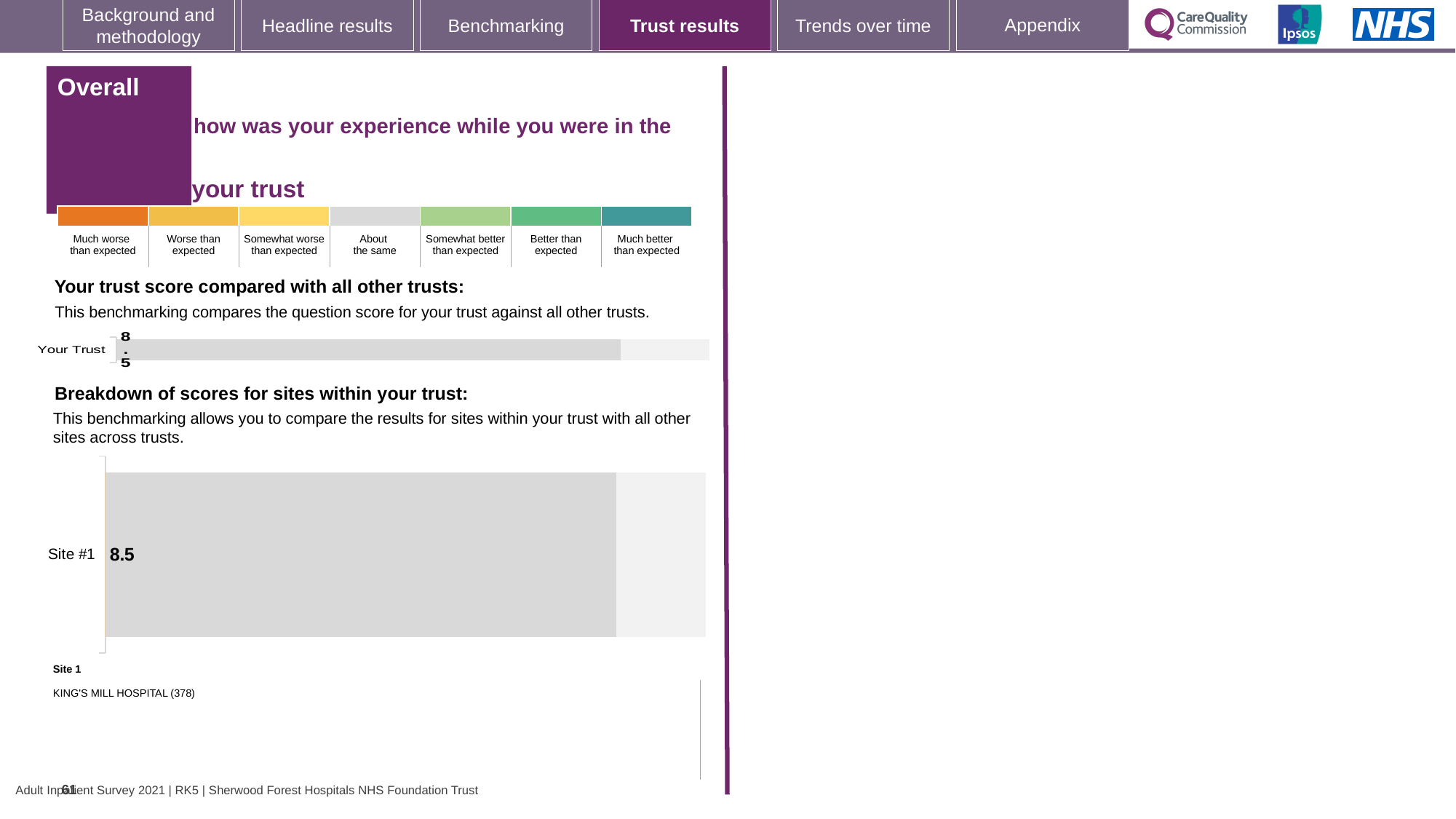
How many bars are plotted in the 'Your trust score compared with all other trusts' chart? 1 According to the note below the site breakdown chart, which hospital is Site 1? KING'S MILL HOSPITAL (378) What kind of chart is the 'Your trust score compared with all other trusts' chart? Bar chart In the 'Breakdown of scores for sites within your trust' chart, what is the value shown for Site #1? 8.5 Is the value for Site #1 in the site breakdown chart the same as the value for Your Trust in the trust score chart? Yes What kind of chart is the 'Breakdown of scores for sites within your trust' chart? Bar chart In the 'Your trust score compared with all other trusts' chart, what is the value shown for Your Trust? 8.5 In the 'Your trust score compared with all other trusts' chart, what is the label of the single category plotted? Your Trust What is the difference between the Your Trust value in the trust score chart and the Site #1 value in the site breakdown chart? 0.0 How many sites are plotted in the 'Breakdown of scores for sites within your trust' chart? 1